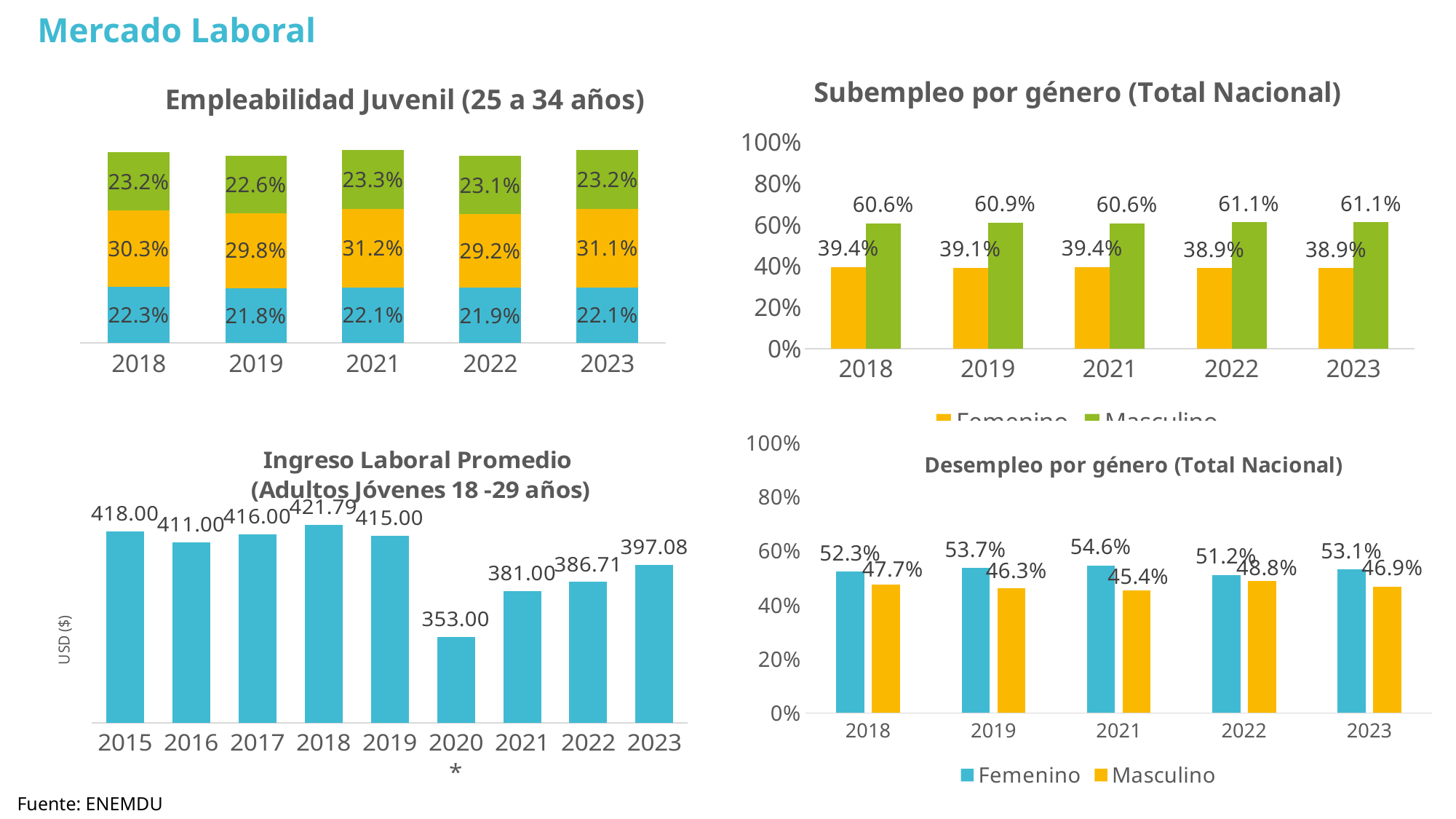
In the 'Desempleo por género (Total Nacional)' chart, which is larger for 2022, Femenino or Masculino? Femenino In the 'Subempleo por género (Total Nacional)' chart, what is the Masculino value for 2019? 60.9% In the 'Ingreso Laboral Promedio' chart, how many years are shown on the x axis? 9 In the 'Ingreso Laboral Promedio' chart, what is the value for 2020? 353.00 In the 'Empleabilidad Juvenil (25 a 34 años)' chart, what is the total of the stacked bar for 2021? 76.6% In the 'Ingreso Laboral Promedio' chart, which year has the highest value? 2018 In the 'Ingreso Laboral Promedio' chart, which year has the lowest value? 2020 In the 'Empleabilidad Juvenil (25 a 34 años)' chart, what is the value of the middle (orange) segment for 2019? 29.8% In the 'Desempleo por género (Total Nacional)' chart, what is the Femenino value for 2021? 54.6% In the 'Subempleo por género (Total Nacional)' chart, what is the difference between the Masculino and Femenino values for 2023? 22.2% In the 'Subempleo por género (Total Nacional)' chart, how many series does the legend list? 2 What kind of chart is 'Empleabilidad Juvenil (25 a 34 años)'? Stacked bar chart